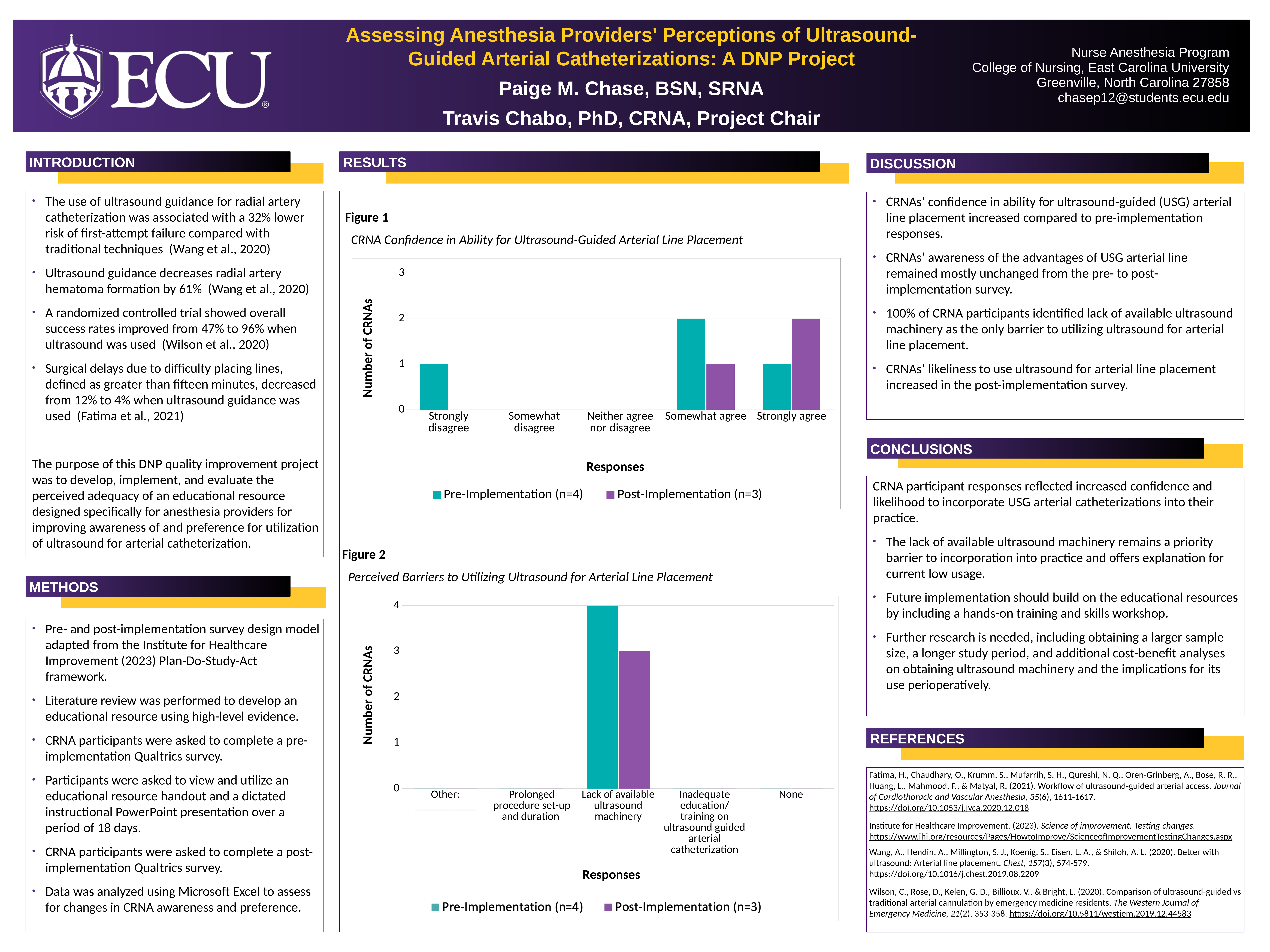
In Figure 1, what is the difference between the Pre-Implementation and Post-Implementation values for 'Somewhat agree'? 1 What type of chart is Figure 1? Bar chart In Figure 1, which response category has the highest Post-Implementation value? Strongly agree In Figure 1, for 'Strongly agree', which series is larger: Pre-Implementation or Post-Implementation? Post-Implementation In Figure 1, how many CRNAs responded 'Strongly agree' in the Post-Implementation survey? 2 In Figure 1, how many CRNAs responded 'Strongly disagree' in the Pre-Implementation survey? 1 In Figure 2, how many CRNAs selected 'Lack of available ultrasound machinery' in the Post-Implementation survey? 3 In Figure 1, how many CRNAs responded 'Somewhat agree' in the Pre-Implementation survey? 2 In Figure 2, which barrier has the highest number of CRNAs? Lack of available ultrasound machinery In Figure 1, how many response categories are shown on the x axis? 5 How many series does the legend of Figure 2 list? 2 In Figure 2, how many CRNAs selected 'Lack of available ultrasound machinery' in the Pre-Implementation survey? 4